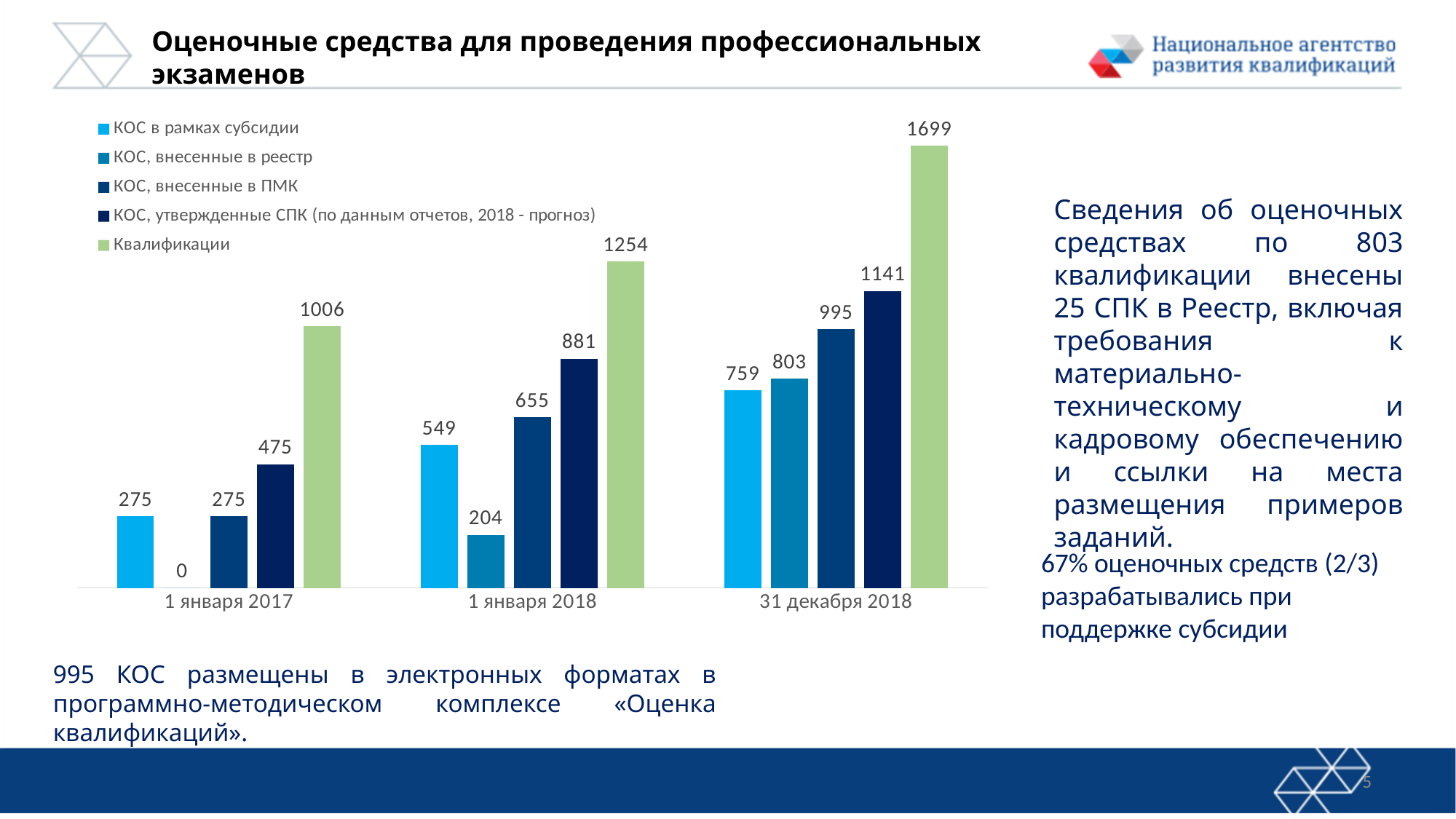
Which date has the lowest value for "КОС, внесенные в реестр"? 1 января 2017 Which is larger for 31 декабря 2018: "КОС в рамках субсидии" or "КОС, внесенные в реестр"? КОС, внесенные в реестр Which date has the highest value for "Квалификации"? 31 декабря 2018 What is the value of "КОС в рамках субсидии" for 1 января 2017? 275 What type of chart is shown on the slide? bar chart What is the difference between the "Квалификации" values for 1 января 2018 and 1 января 2017? 248 What is the value of "КОС, внесенные в реестр" for 1 января 2018? 204 Do the values for "КОС, утвержденные СПК" rise or fall from 1 января 2017 to 31 декабря 2018? rise What is the value of "КОС, внесенные в ПМК" for 31 декабря 2018? 995 What is the value of "Квалификации" for 31 декабря 2018? 1699 How many date categories are shown on the x axis of the chart? 3 How many series does the chart legend list? 5